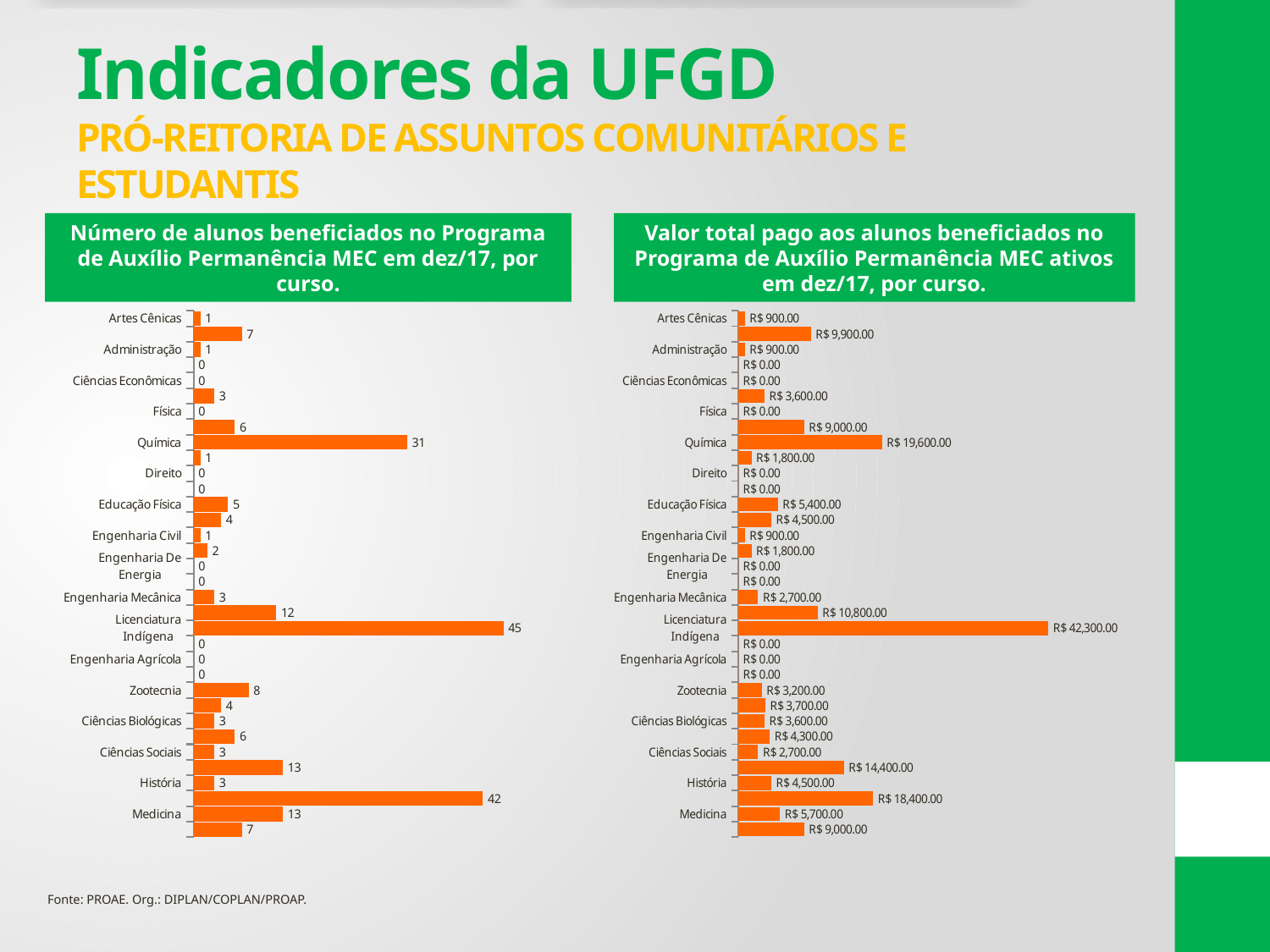
In the left chart (Número de alunos beneficiados), which is larger, the value for Zootecnia or the value for Engenharia Mecânica? Zootecnia In the right chart (Valor total pago), what is the value for Licenciatura Indígena? R$ 42,300.00 In the right chart (Valor total pago), what is the value for Medicina? R$ 5,700.00 In the left chart (Número de alunos beneficiados), how many students are shown for Química? 31 In the left chart (Número de alunos beneficiados), what is the difference between Química and Educação Física? 26 In the right chart (Valor total pago), what is the difference between Educação Física and História? R$ 900.00 In the left chart (Número de alunos beneficiados), which labelled course has the highest number of students? Licenciatura Indígena In the left chart (Número de alunos beneficiados), what is the value for Zootecnia? 8 What type of chart is used on the left side of the slide? Bar chart In the left chart (Número de alunos beneficiados), what is the value for Medicina? 13 In the right chart (Valor total pago), what is the value for Química? R$ 19,600.00 In the right chart (Valor total pago), which is larger, the value for Ciências Biológicas or the value for Ciências Sociais? Ciências Biológicas